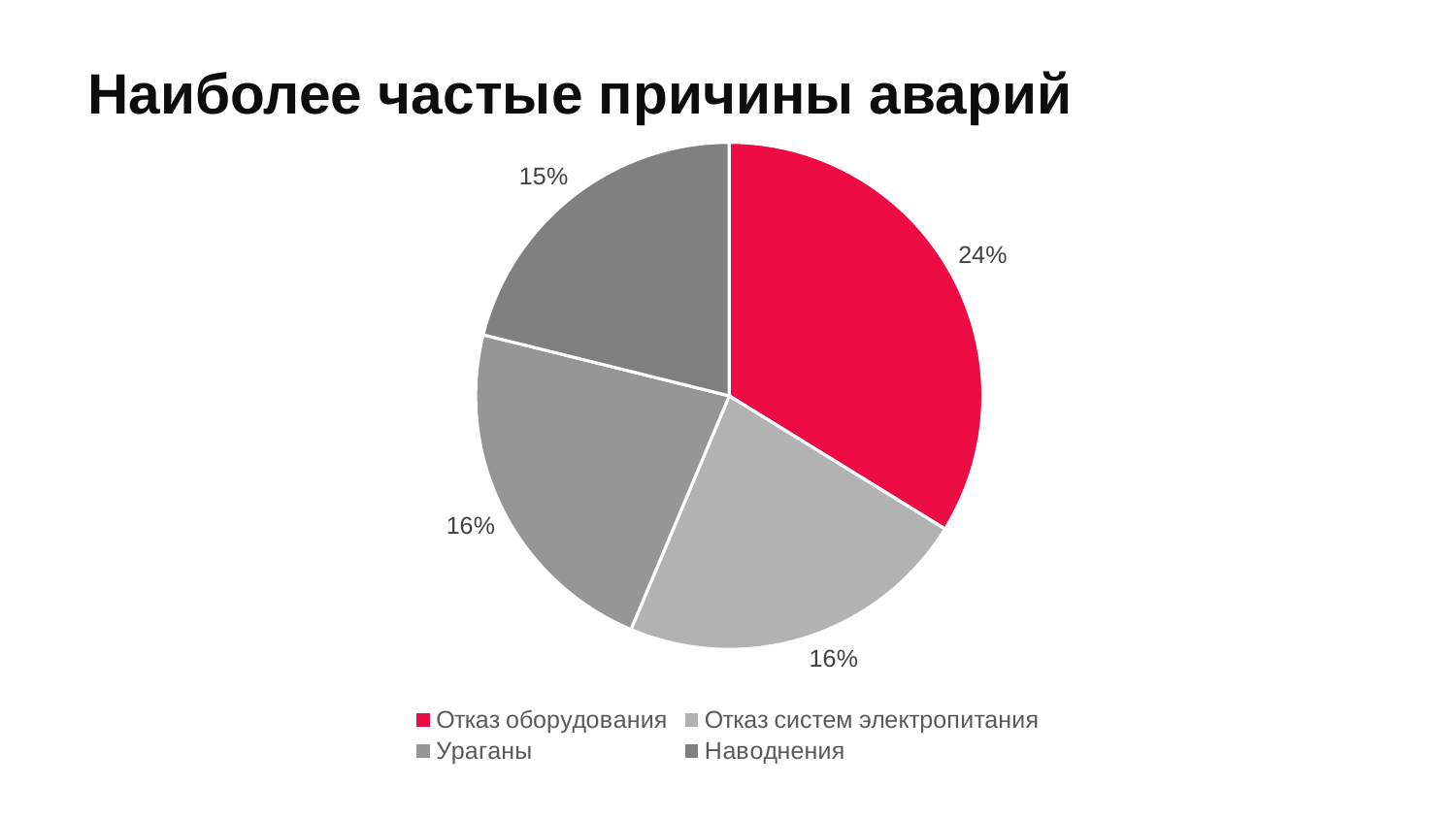
What percentage is shown for Отказ оборудования? 24% What percentage is shown for Отказ систем электропитания? 16% Which cause has the smallest slice of the pie? Наводнения Which is larger, the slice for Отказ оборудования or the slice for Ураганы? Отказ оборудования How many entries does the legend list? 4 What is the difference in percentage points between Отказ оборудования and Наводнения? 9 What percentage is shown for Ураганы? 16% What is the title of the chart? Наиболее частые причины аварий What percentage is shown for Наводнения? 15% What kind of chart is shown on the slide? Pie chart Which cause has the largest slice of the pie? Отказ оборудования How many slices does the pie chart have? 4